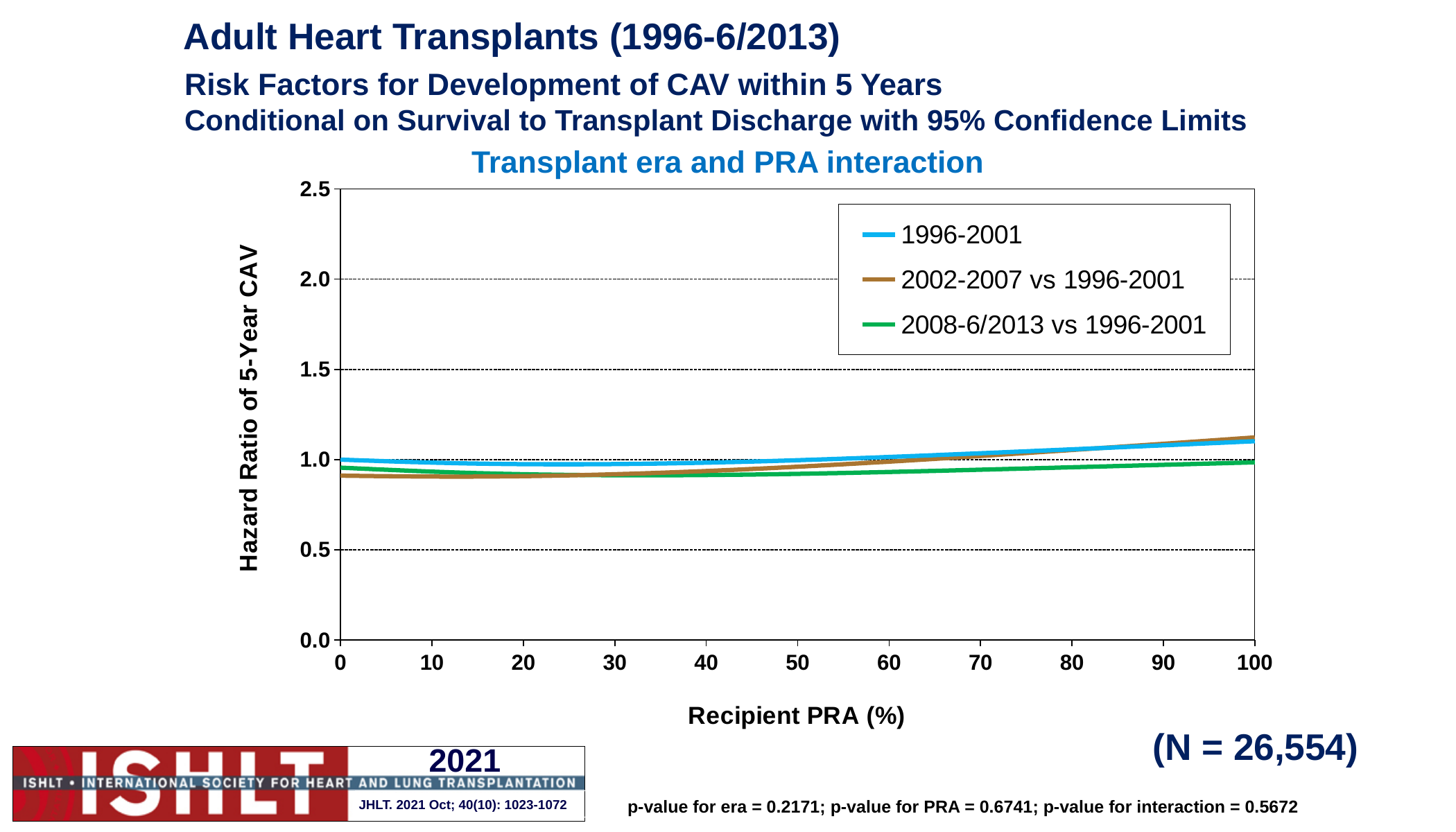
Does the 1996-2001 series rise or fall between a Recipient PRA of 50% and 100%? rise What kind of chart is shown on the slide? line chart What is the sample size (N) shown on the slide? 26,554 What is the label of the x axis? Recipient PRA (%) At a Recipient PRA of 100%, which series has the lower value: 1996-2001 or 2008-6/2013 vs 1996-2001? 2008-6/2013 vs 1996-2001 Is the value for the 2008-6/2013 vs 1996-2001 series at a Recipient PRA of 50% greater or less than 1.5? less What is the title of the chart? Transplant era and PRA interaction Is the value for the 1996-2001 series at a Recipient PRA of 0% greater or less than 0.5? greater Is the value for the 2002-2007 vs 1996-2001 series at a Recipient PRA of 100% greater or less than 2.0? less How many series does the legend list? 3